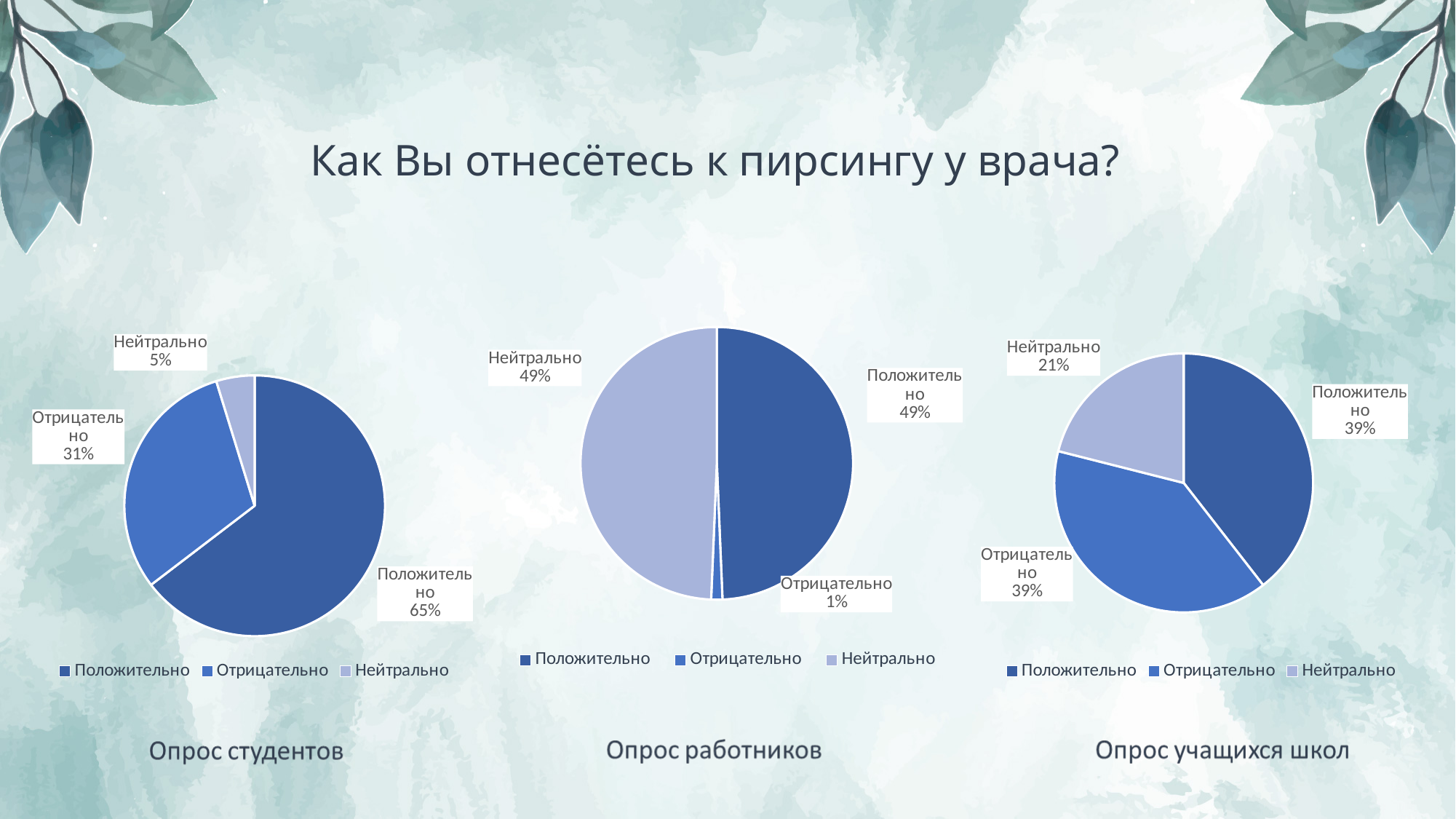
In the "Опрос студентов" chart, what is the difference between the "Положительно" and "Отрицательно" shares? 34% In the "Опрос работников" chart, what share of respondents answered "Нейтрально"? 49% In the "Опрос работников" chart, what share of respondents answered "Отрицательно"? 1% In the "Опрос работников" chart, which response has the smallest share? Отрицательно In the "Опрос учащихся школ" chart, what is the difference between the "Положительно" and "Нейтрально" shares? 18% What type of chart is used for "Опрос студентов"? Pie chart Which is larger: the "Отрицательно" share in the "Опрос студентов" chart or the "Отрицательно" share in the "Опрос работников" chart? Опрос студентов How many entries does the legend of the "Опрос работников" chart list? 3 In the "Опрос студентов" chart, which response has the smallest share? Нейтрально In the "Опрос учащихся школ" chart, what share of respondents answered "Нейтрально"? 21% In the "Опрос студентов" chart, what share of respondents answered "Положительно"? 65% In the "Опрос учащихся школ" chart, which response has the smallest share? Нейтрально